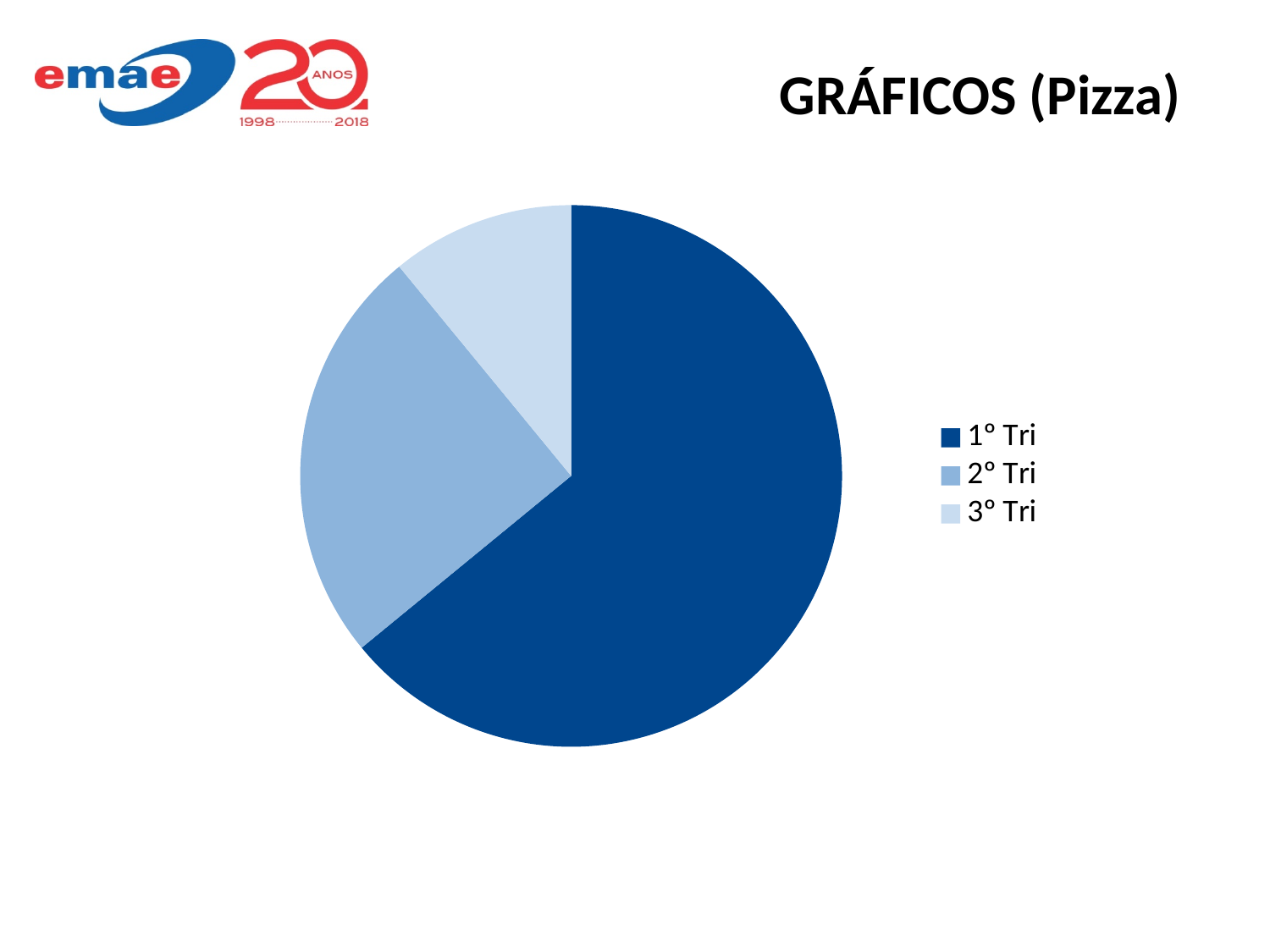
Which slice is larger, 1° Tri or 2° Tri? 1° Tri Does the 1° Tri slice take up more or less than half of the pie chart? more What is the title shown on the slide above the pie chart? GRÁFICOS (Pizza) Which slice is larger, 2° Tri or 3° Tri? 2° Tri Which category has the largest slice of the pie chart? 1° Tri How many slices does the pie chart have? 3 What kind of chart is shown on the slide? pie chart Which category has the smallest slice of the pie chart? 3° Tri Which legend entry is shown in the darkest blue colour? 1° Tri How many entries does the legend of the pie chart list? 3